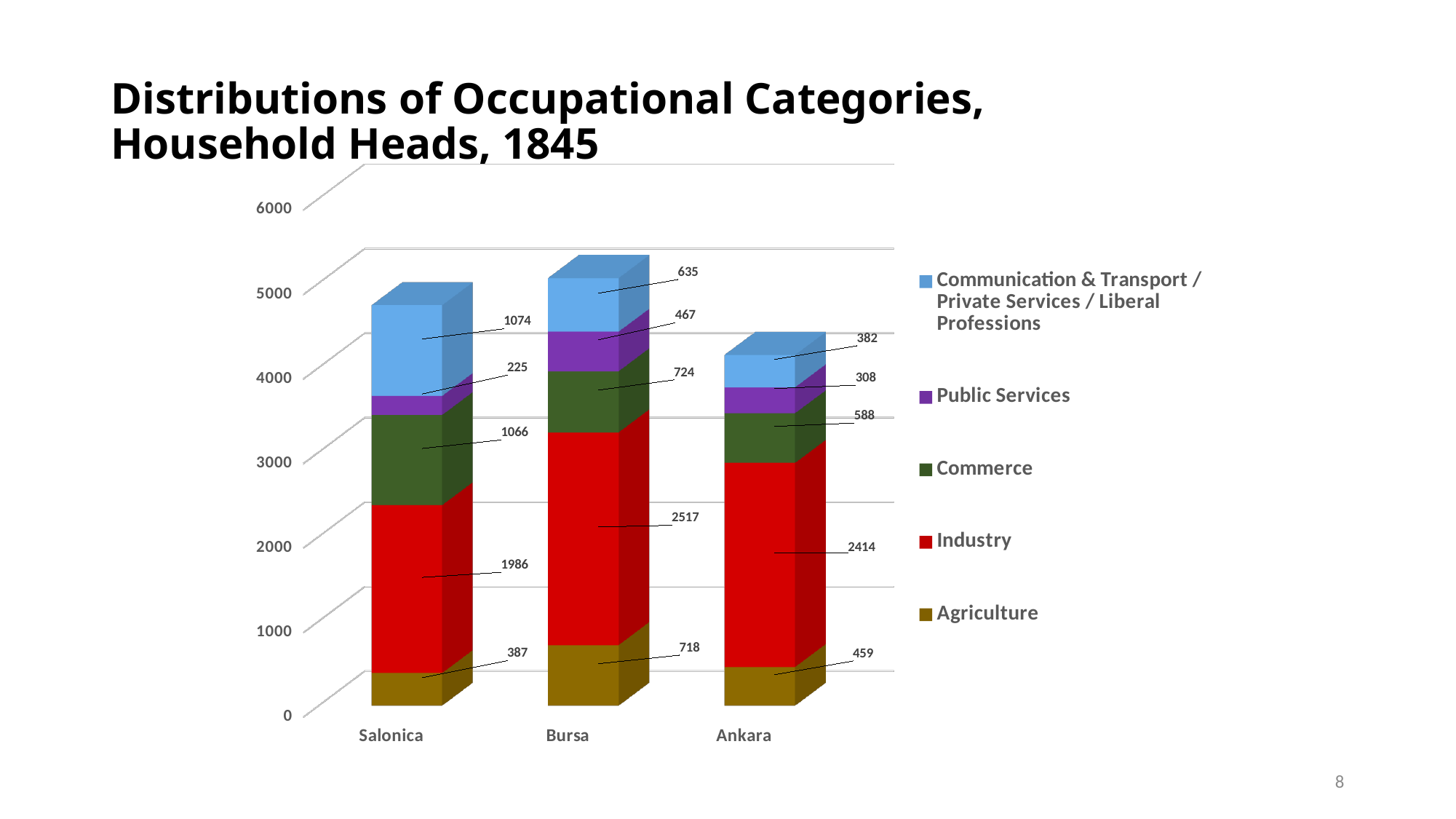
What is the title of the slide? Distributions of Occupational Categories, Household Heads, 1845 How many cities are shown on the x axis? 3 Which city has the lowest Public Services value? Salonica What is the difference between the Industry values for Bursa and Ankara? 103 How many series does the legend list? 5 What is the total of the stacked bar for Bursa? 5061 Which city has the highest Industry value? Bursa Which city has the larger Commerce value, Salonica or Bursa? Salonica What is the Industry value for Bursa? 2517 What is the Communication & Transport / Private Services / Liberal Professions value for Ankara? 382 What kind of chart is shown on the slide? Stacked bar chart What is the Agriculture value for Salonica? 387